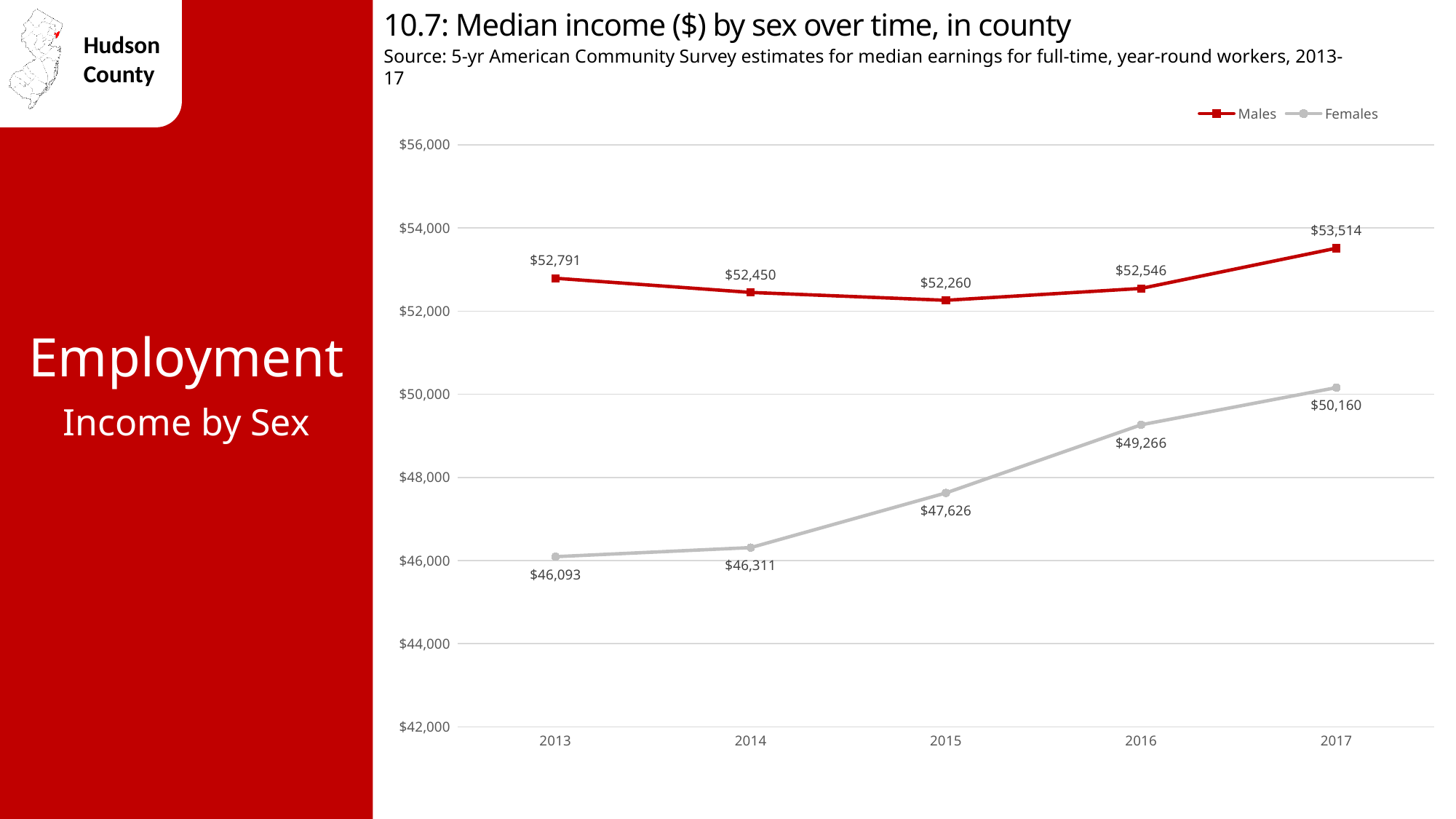
Is the median income for Females in 2016 greater or less than $50,000? less Which series had the higher median income in 2016, Males or Females? Males What was the median income for Females in 2017? $50,160 Does the median income for Females rise or fall from 2013 to 2017? rise In which year was the median income for Males lowest? 2015 What is the difference between the Males and Females median income in 2017? $3,354 How many years are shown on the x axis? 5 What was the median income for Females in 2015? $47,626 What kind of chart is shown on the slide? line chart What was the median income for Males in 2013? $52,791 How many series does the legend list? 2 In which year was the median income for Females highest? 2017